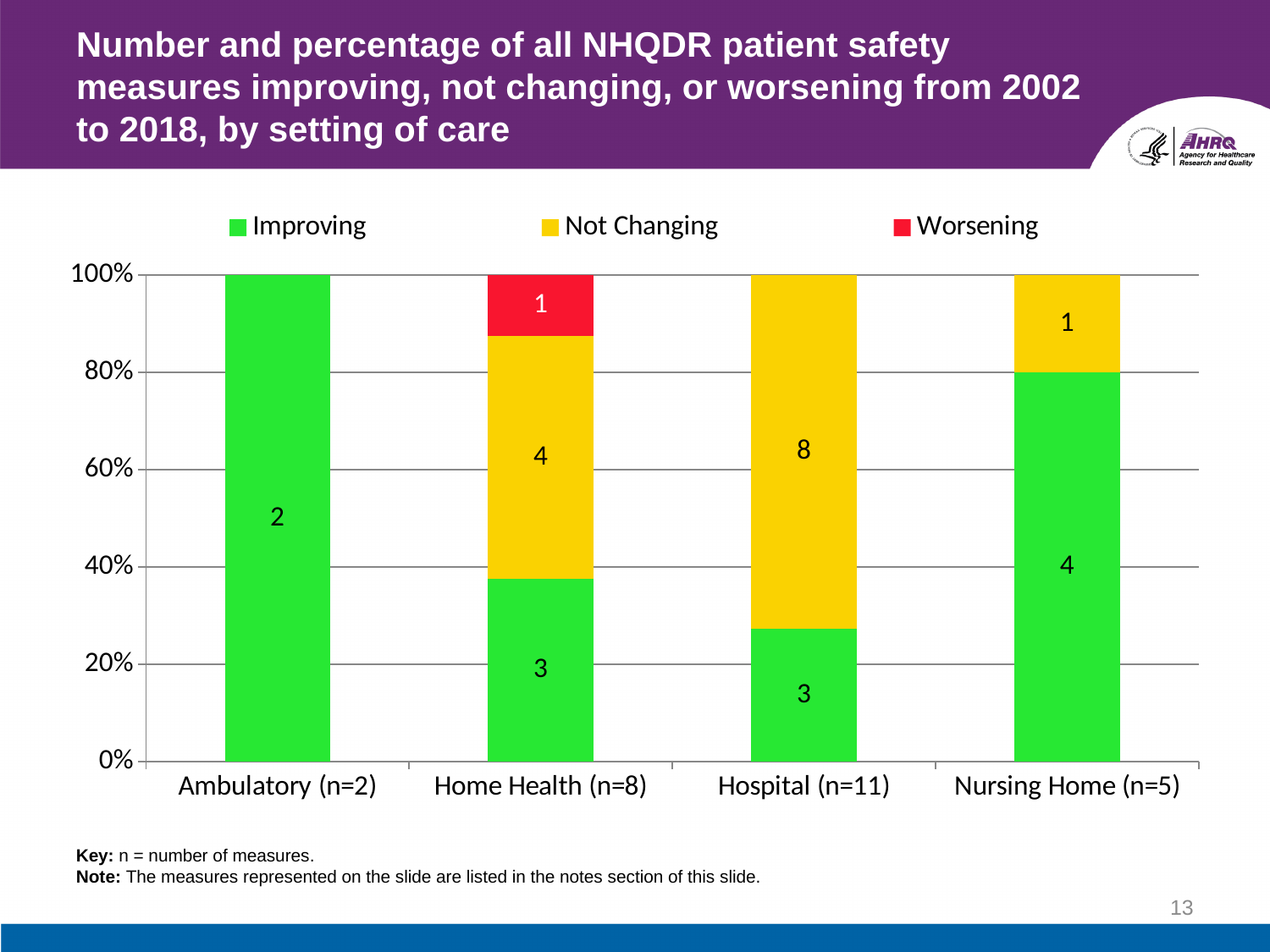
How many Worsening measures are shown for Home Health (n=8)? 1 What is the total number of measures in the Home Health bar? 8 How many Improving measures are shown for Nursing Home (n=5)? 4 What kind of chart is shown on the slide? Stacked bar chart Which setting of care has the lowest number of Improving measures? Ambulatory (n=2) Which has more Improving measures, Nursing Home (n=5) or Home Health (n=8)? Nursing Home (n=5) How many settings of care are shown on the x axis? 4 How many series does the legend list? 3 How many Improving measures are shown for Ambulatory (n=2)? 2 What is the difference between the number of Not Changing measures for Hospital (n=11) and Home Health (n=8)? 4 How many Not Changing measures are shown for Hospital (n=11)? 8 Which setting of care has the highest number of Not Changing measures? Hospital (n=11)